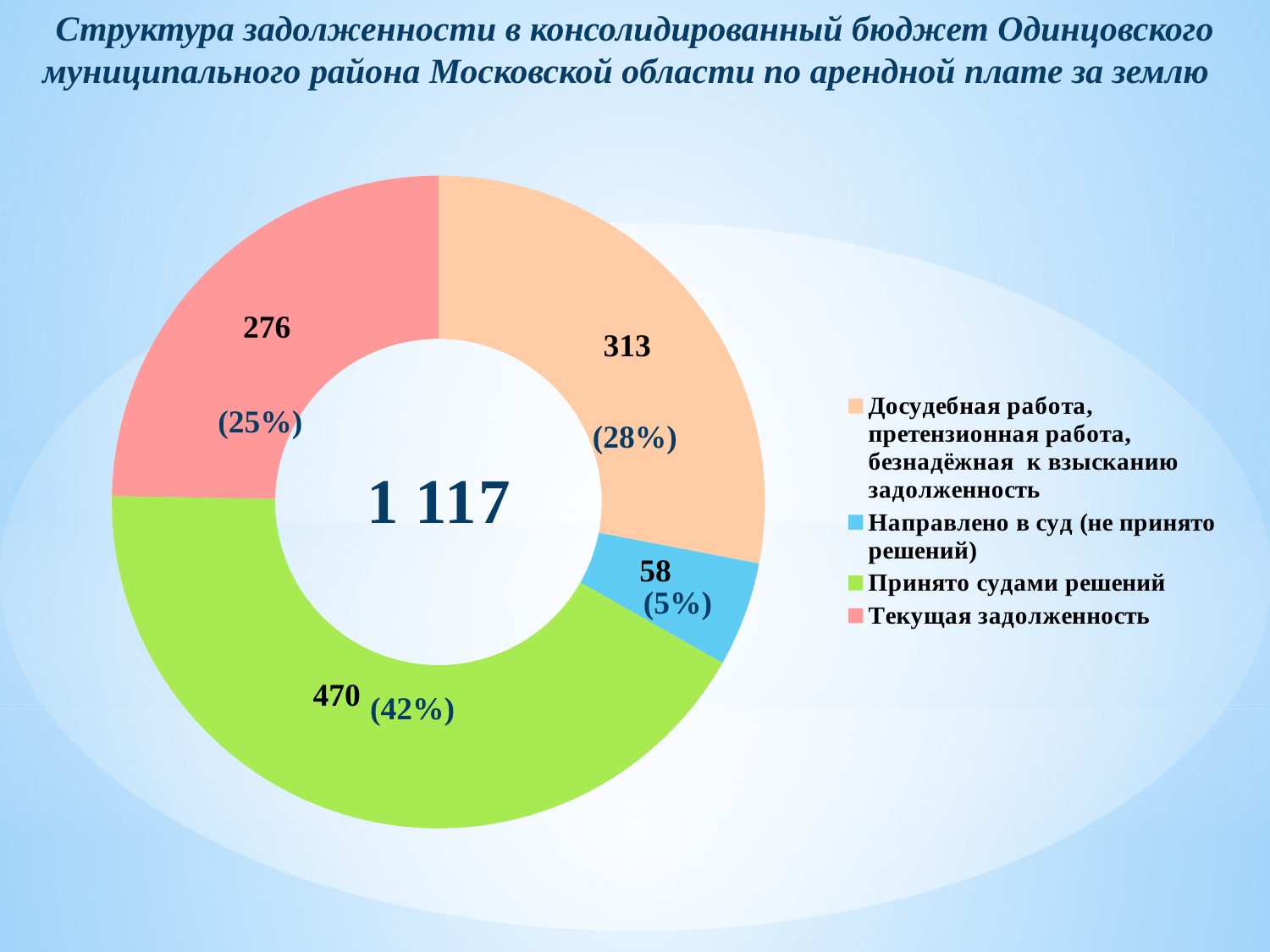
What share of the chart does the slice "Принято судами решений" represent? 42% What value is shown for the slice "Текущая задолженность"? 276 Which is larger: the value for "Досудебная работа, претензионная работа, безнадёжная к взысканию задолженность" or the value for "Текущая задолженность"? Досудебная работа, претензионная работа, безнадёжная к взысканию задолженность What value is shown for the slice "Направлено в суд (не принято решений)"? 58 What value is shown for the slice "Принято судами решений"? 470 Which category has the smallest slice? Направлено в суд (не принято решений) What kind of chart is shown on the slide? Doughnut chart What share of the chart does the slice "Текущая задолженность" represent? 25% What value is shown for the slice "Досудебная работа, претензионная работа, безнадёжная к взысканию задолженность"? 313 What is the difference between the values for "Принято судами решений" and "Текущая задолженность"? 194 How many categories does the legend list? 4 Which category has the largest slice? Принято судами решений